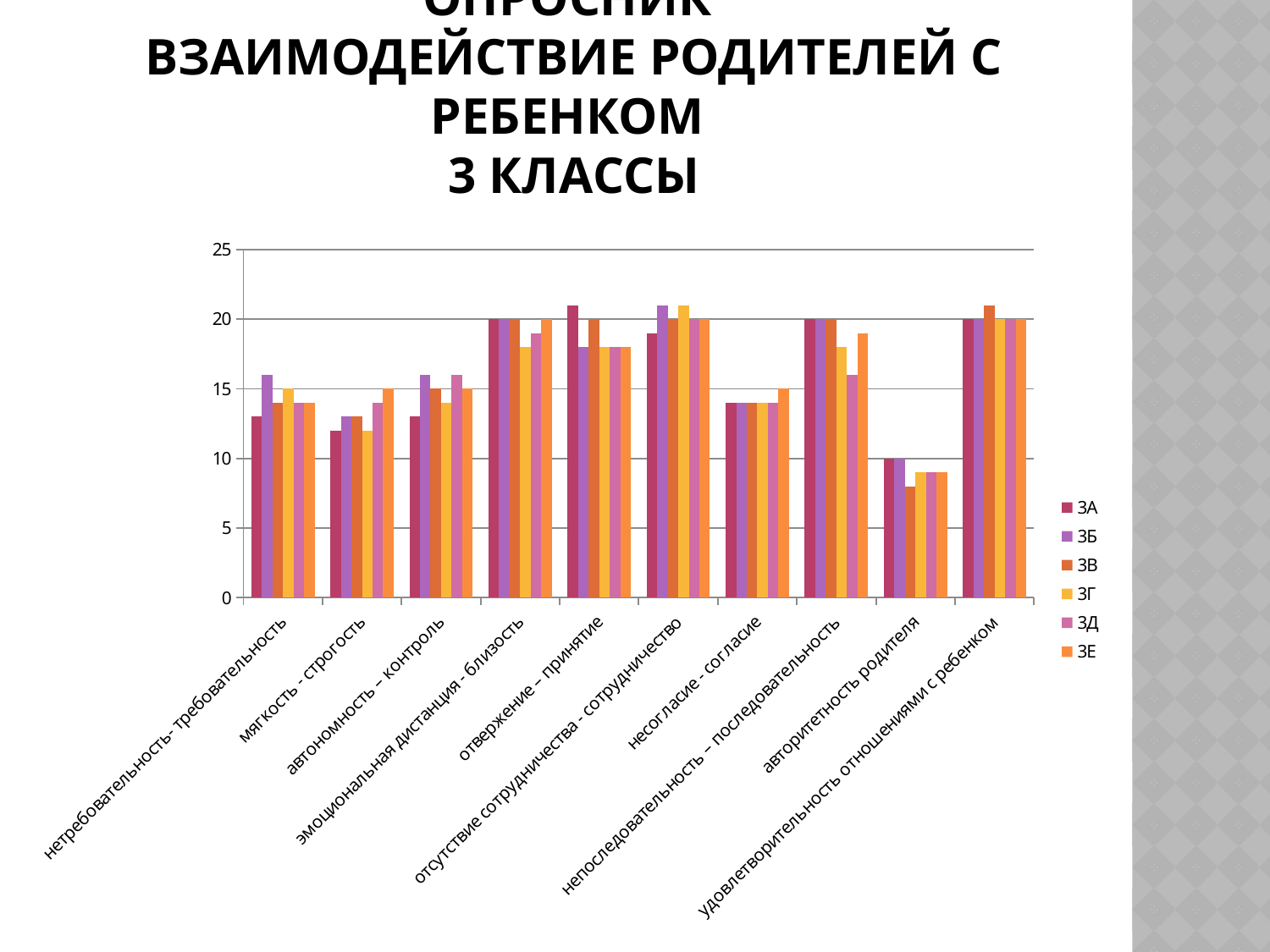
Is the value for 3В in 'авторитетность родителя' greater or less than 10? less Which series are listed in the legend? 3А, 3Б, 3В, 3Г, 3Д, 3Е How many series does the legend list? 6 What kind of chart is shown on the slide? bar chart What is the value for 3А in the category 'авторитетность родителя'? 10 Which category has the lowest bars overall? авторитетность родителя Is the value for 3А in 'отвержение – принятие' greater or less than 20? greater Is the value for 3А in 'мягкость - строгость' greater or less than 15? less What is the value for 3Е in the category 'несогласие - согласие'? 15 Which is larger for 3А: the value in 'несогласие - согласие' or in 'непоследовательность – последовательность'? непоследовательность – последовательность How many categories are shown along the x axis? 10 What is the value for 3В in the category 'эмоциональная дистанция - близость'? 20